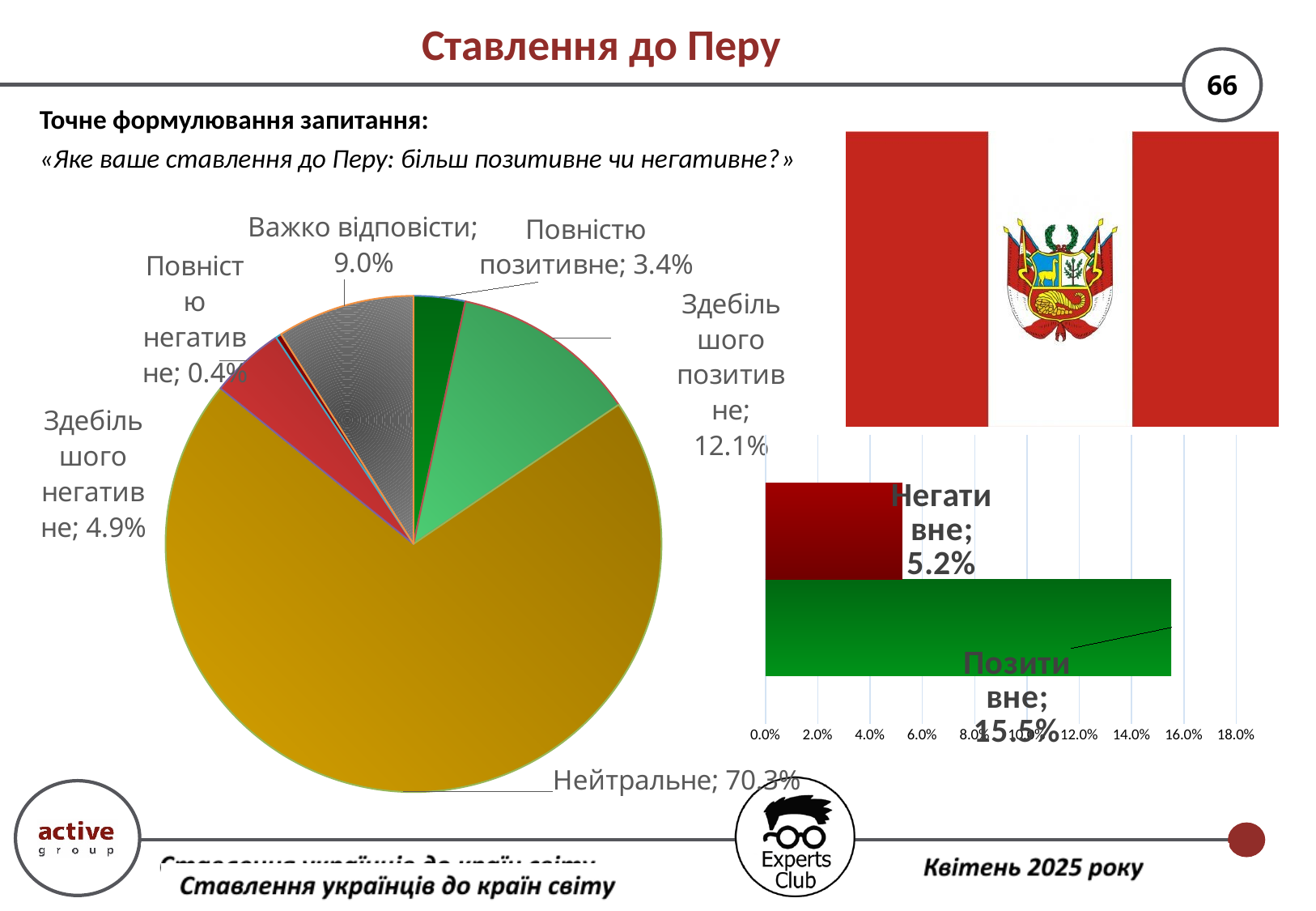
In the bar chart on the right, what is the difference between "Позитивне" and "Негативне"? 10.3% In the pie chart, what share is labelled for "Нейтральне"? 70.3% In the pie chart, what is the difference between "Здебільшого позитивне" and "Здебільшого негативне"? 7.2% In the pie chart, what is the value for "Здебільшого позитивне"? 12.1% In the pie chart, which category has the largest slice? Нейтральне In the pie chart, which category has the smallest slice? Повністю негативне In the pie chart, which is larger: "Повністю позитивне" or "Здебільшого негативне"? Здебільшого негативне In the pie chart, how many slices are there? 6 In the pie chart, what is the value for "Важко відповісти"? 9.0% In the bar chart on the right, what is the value for "Позитивне"? 15.5% In the bar chart on the right, what is the value for "Негативне"? 5.2% What type of chart is shown on the right side of the slide below the flag? Bar chart